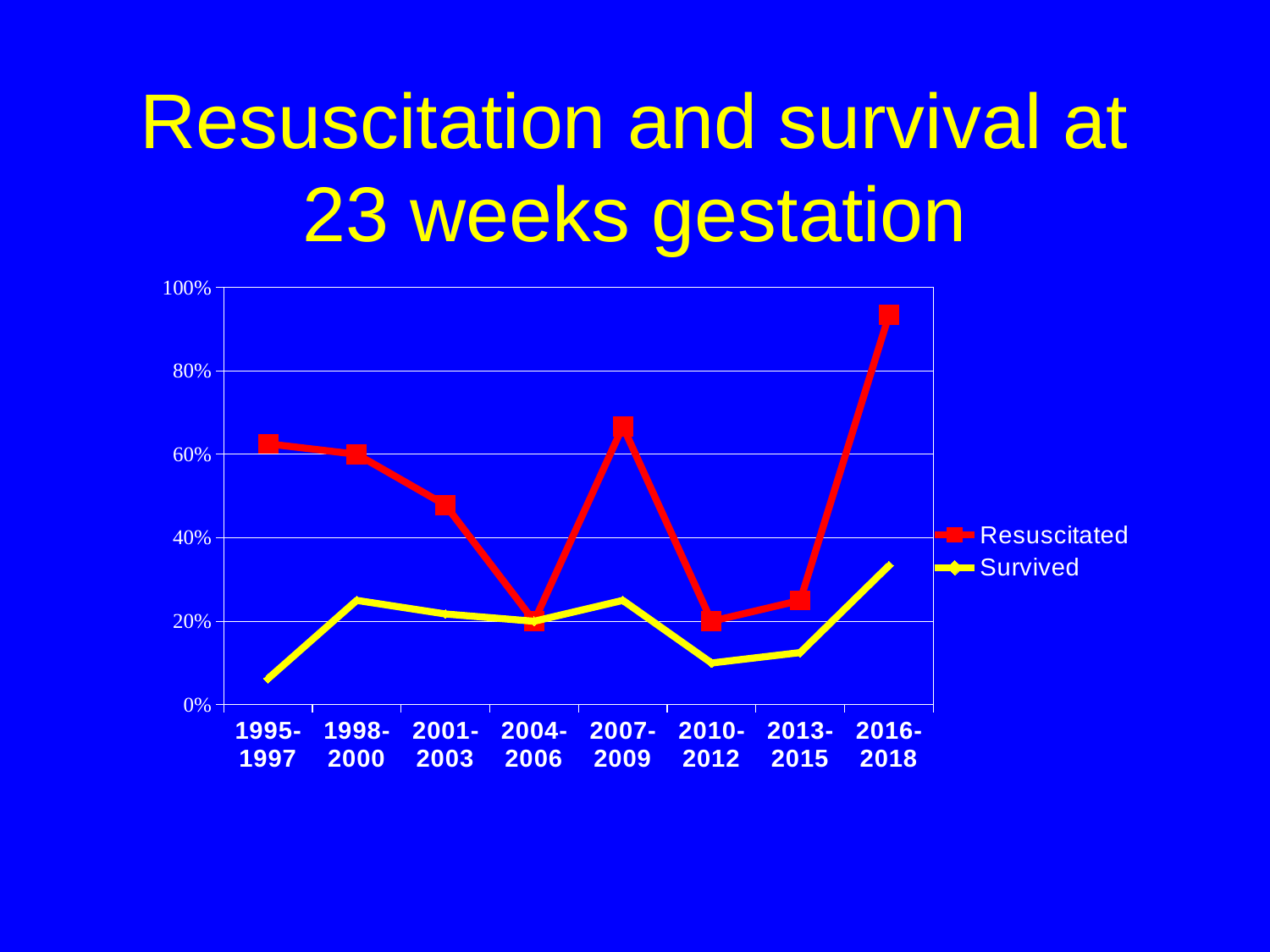
How many series does the legend list? 2 Which is larger for 1995-1997, the Resuscitated value or the Survived value? Resuscitated Is the Resuscitated value for 2001-2003 greater or less than 40%? greater Does the Resuscitated line rise or fall from 1995-1997 to 2004-2006? Fall What kind of chart is shown on the slide? Line chart Which series is drawn in yellow? Survived In which period is the Survived value lowest? 1995-1997 Is the Survived value for 1995-1997 greater or less than 20%? less How many time periods are shown on the x axis? 8 Is the Resuscitated value for 2016-2018 greater or less than 80%? greater In which period is the Survived value highest? 2016-2018 In which period is the Resuscitated value highest? 2016-2018